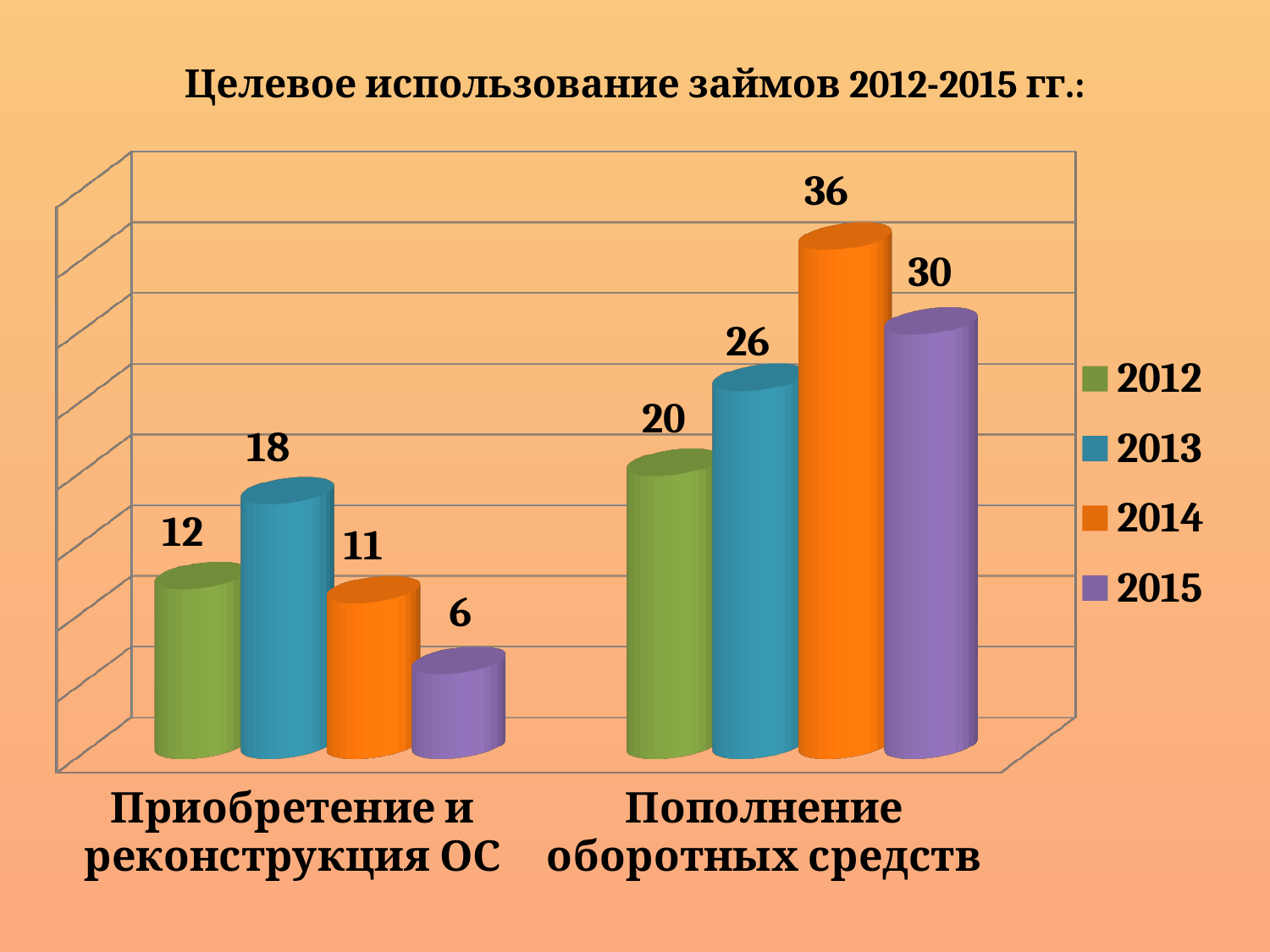
Which year has the lowest value in the "Приобретение и реконструкция ОС" category? 2015 What is the value for 2012 in the "Пополнение оборотных средств" category? 20 What is the value for 2013 in the "Приобретение и реконструкция ОС" category? 18 What is the value for 2015 in the "Приобретение и реконструкция ОС" category? 6 How many categories are shown on the x axis? 2 What is the title of the chart? Целевое использование займов 2012-2015 гг.: What is the difference between the 2013 and 2012 values in the "Приобретение и реконструкция ОС" category? 6 How many series does the legend list? 4 Which is larger: the 2013 value for "Пополнение оборотных средств" or the 2013 value for "Приобретение и реконструкция ОС"? Пополнение оборотных средств What is the difference between the 2014 and 2015 values in the "Пополнение оборотных средств" category? 6 Which year has the highest value in the "Пополнение оборотных средств" category? 2014 What is the value for 2014 in the "Пополнение оборотных средств" category? 36